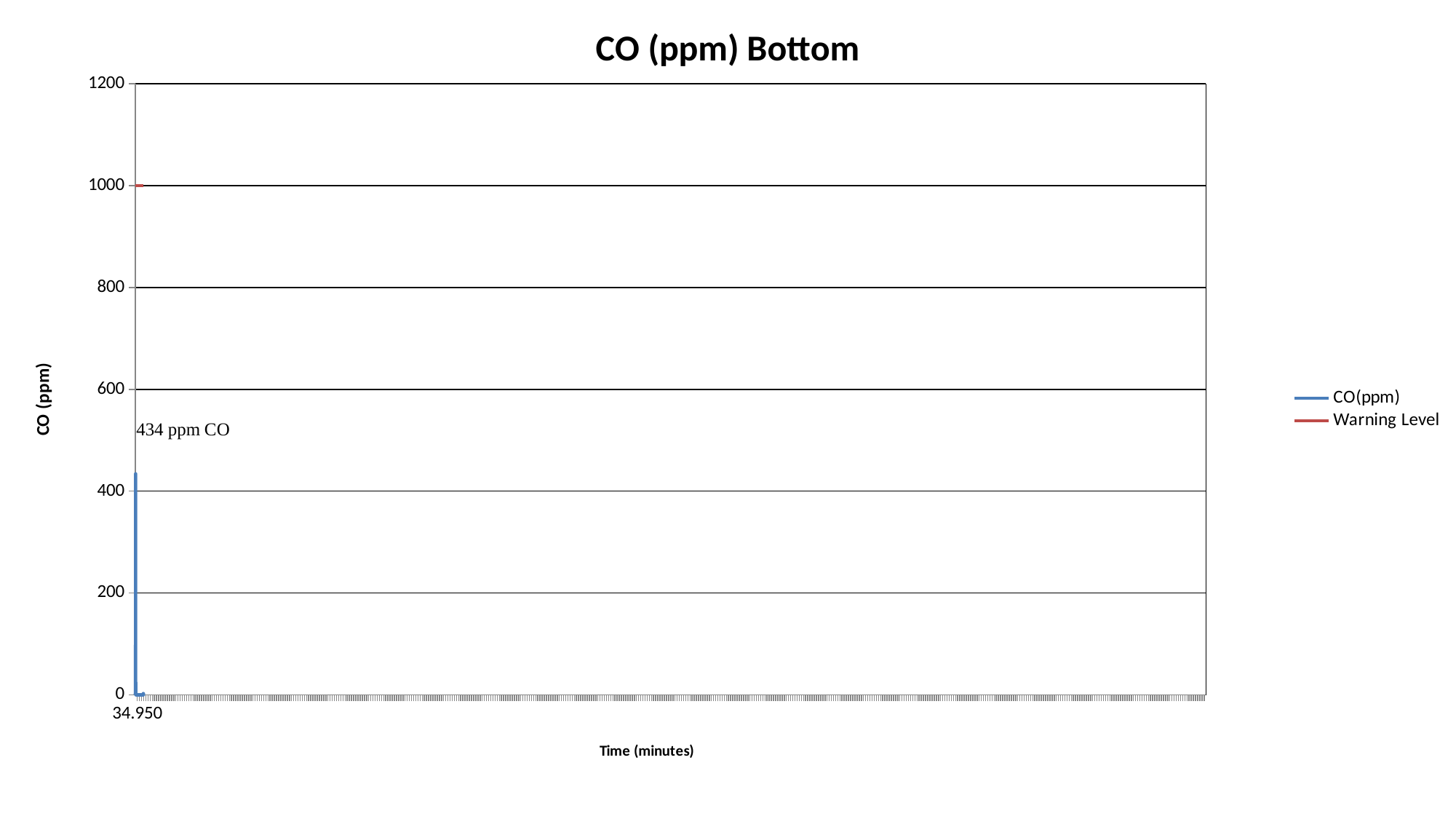
Is the Warning Level greater or less than 800? greater Is the peak value of the CO(ppm) series greater or less than 400? greater What are the two series named in the legend? CO(ppm) and Warning Level What is the title of the chart? CO (ppm) Bottom At what CO (ppm) level is the Warning Level series plotted? 1000 How many series does the legend list? 2 Is the peak value of the CO(ppm) series greater or less than 600? less What peak CO value is annotated on the chart? 434 ppm CO Which is higher, the peak CO(ppm) value or the Warning Level? Warning Level What is the highest value shown on the y axis? 1200 What type of chart is shown on the slide? line chart What is the only time value labelled on the x axis? 34.950